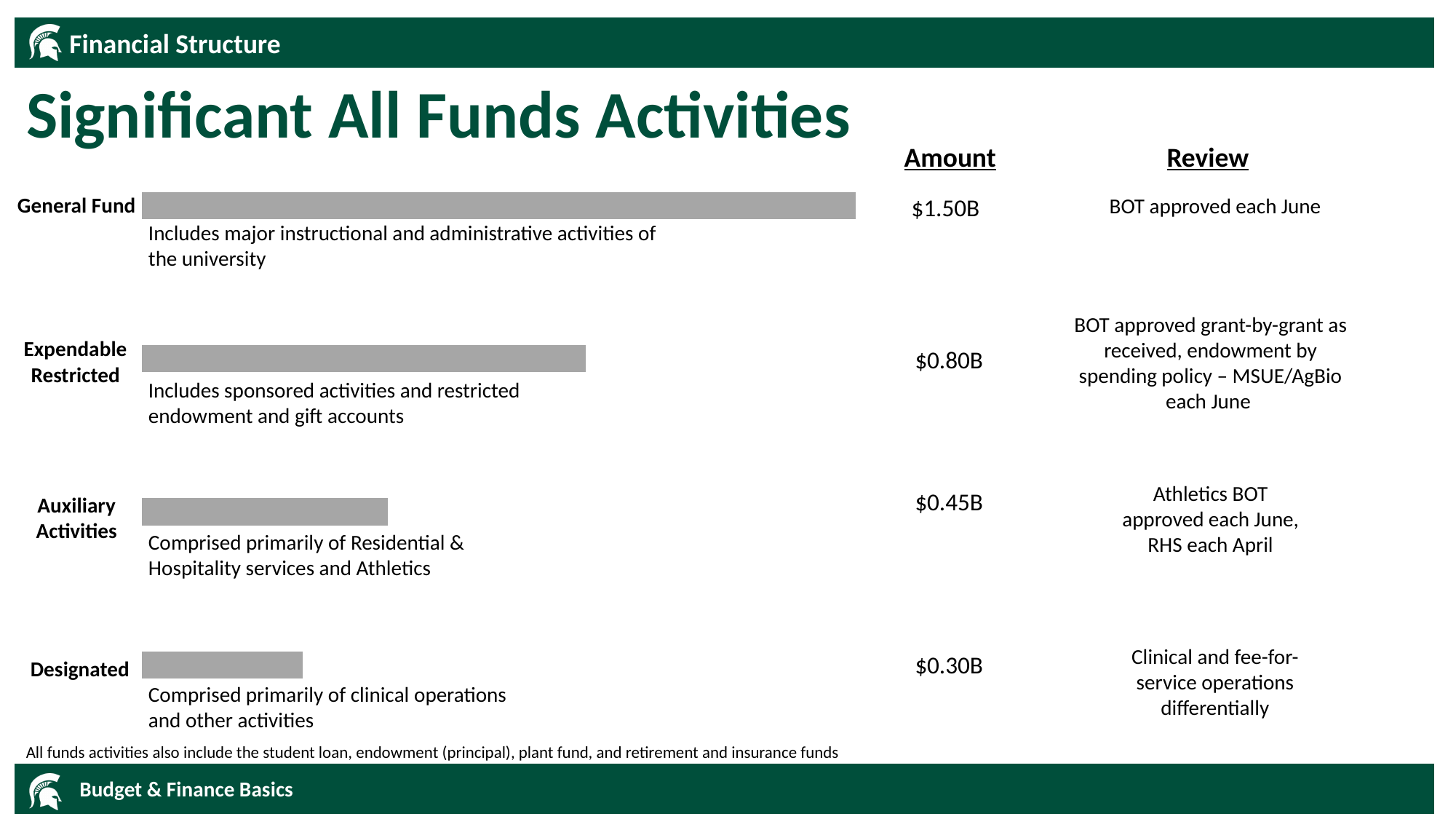
What is the difference between the Auxiliary Activities amount and the Designated amount? $0.15B What is the amount for Expendable Restricted? $0.80B Which fund activity has the largest amount? General Fund How many fund activities are shown as bars on the slide? 4 What is the title of the slide containing the chart? Significant All Funds Activities What kind of chart is used to show the fund amounts? Bar chart Which fund activity has the smallest amount? Designated Which is larger, the amount for Expendable Restricted or the amount for Auxiliary Activities? Expendable Restricted What is the amount for Designated? $0.30B What is the amount for Auxiliary Activities? $0.45B What is the difference between the General Fund amount and the Expendable Restricted amount? $0.70B What is the amount for the General Fund? $1.50B